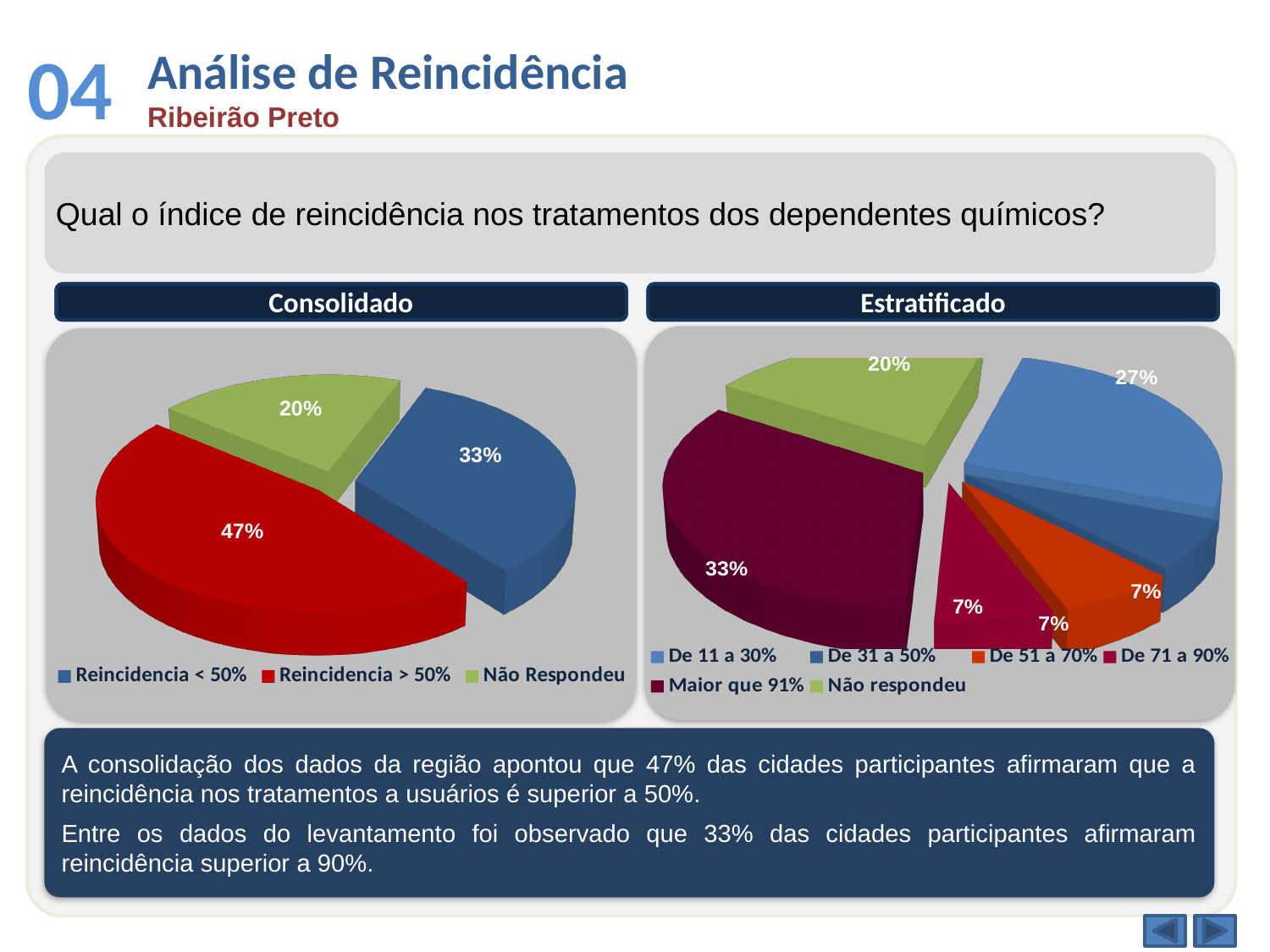
On the Consolidado chart, what percentage is shown for Reincidencia < 50%? 33% On the Estratificado chart, what percentage is shown for Não respondeu? 20% On the Consolidado chart, which category has the smallest slice? Não Respondeu On the Consolidado chart, which category has the largest slice? Reincidencia > 50% On the Consolidado chart, what percentage is shown for Não Respondeu? 20% How many categories does the legend of the Estratificado chart list? 6 On the Consolidado chart, what percentage is shown for Reincidencia > 50%? 47% On the Consolidado chart, what is the difference between Reincidencia > 50% and Reincidencia < 50%? 14 percentage points On the Estratificado chart, what percentage is shown for De 51 a 70%? 7% On the Estratificado chart, which category has the largest slice? Maior que 91% What type of chart is the Consolidado chart? Pie chart On the Estratificado chart, what percentage is shown for Maior que 91%? 33%